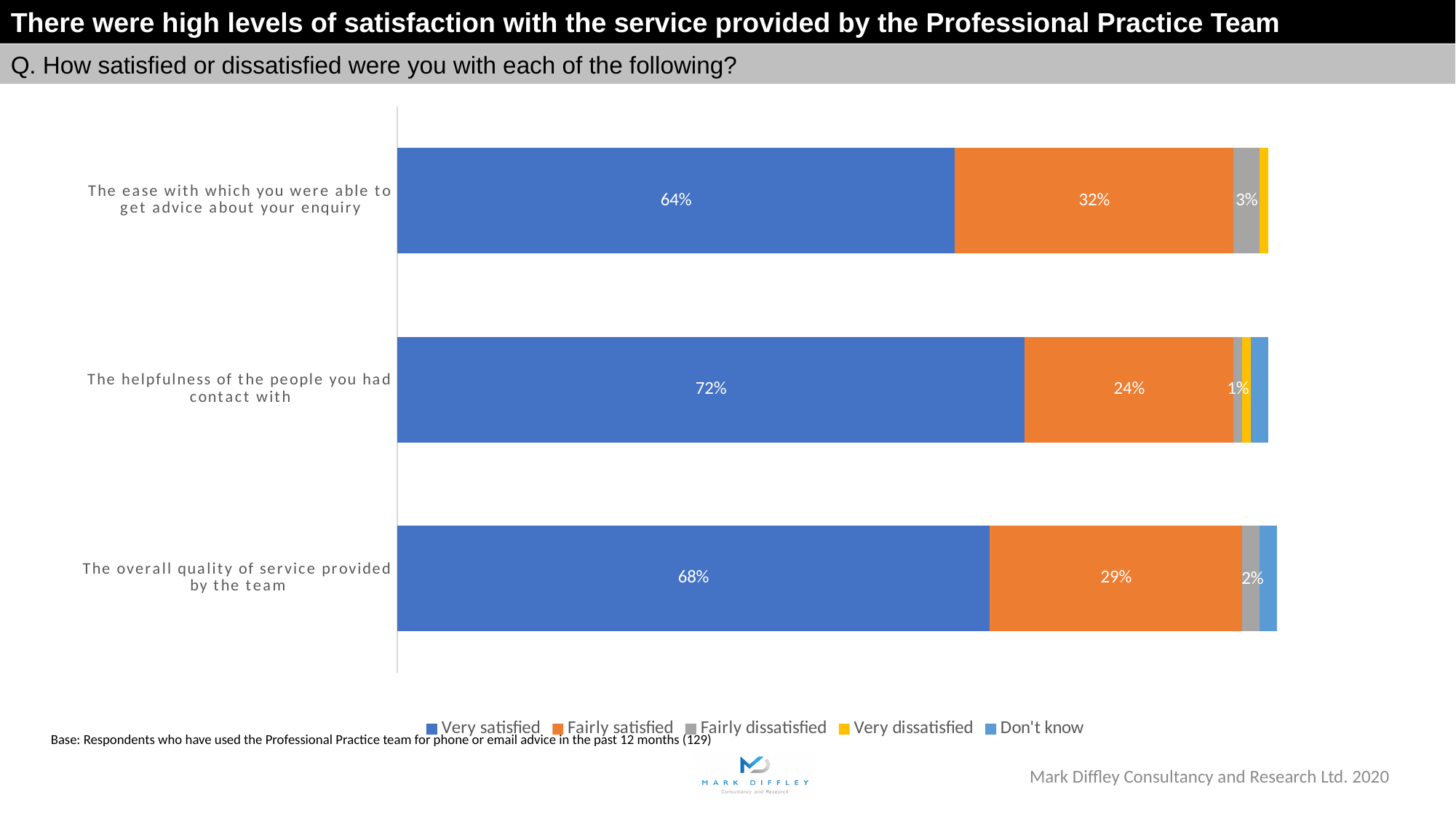
Which colour represents 'Very dissatisfied' in the legend? Yellow Which item has the highest percentage of very satisfied respondents? The helpfulness of the people you had contact with How many items are shown on the chart? 3 What percentage of respondents were very satisfied with the overall quality of service provided by the team? 68% How many series does the legend list? 5 What percentage of respondents were fairly satisfied with the helpfulness of the people they had contact with? 24% What percentage of respondents were very satisfied with the ease with which they were able to get advice about their enquiry? 64% What kind of chart is shown on the slide? Stacked bar chart What is the difference in the very satisfied percentage between the helpfulness of the people you had contact with and the ease with which you were able to get advice about your enquiry? 8% Which has a larger fairly satisfied percentage: the ease with which you were able to get advice about your enquiry or the overall quality of service provided by the team? The ease with which you were able to get advice about your enquiry Which item has the lowest percentage of very satisfied respondents? The ease with which you were able to get advice about your enquiry What percentage of respondents were fairly dissatisfied with the ease with which they were able to get advice about their enquiry? 3%